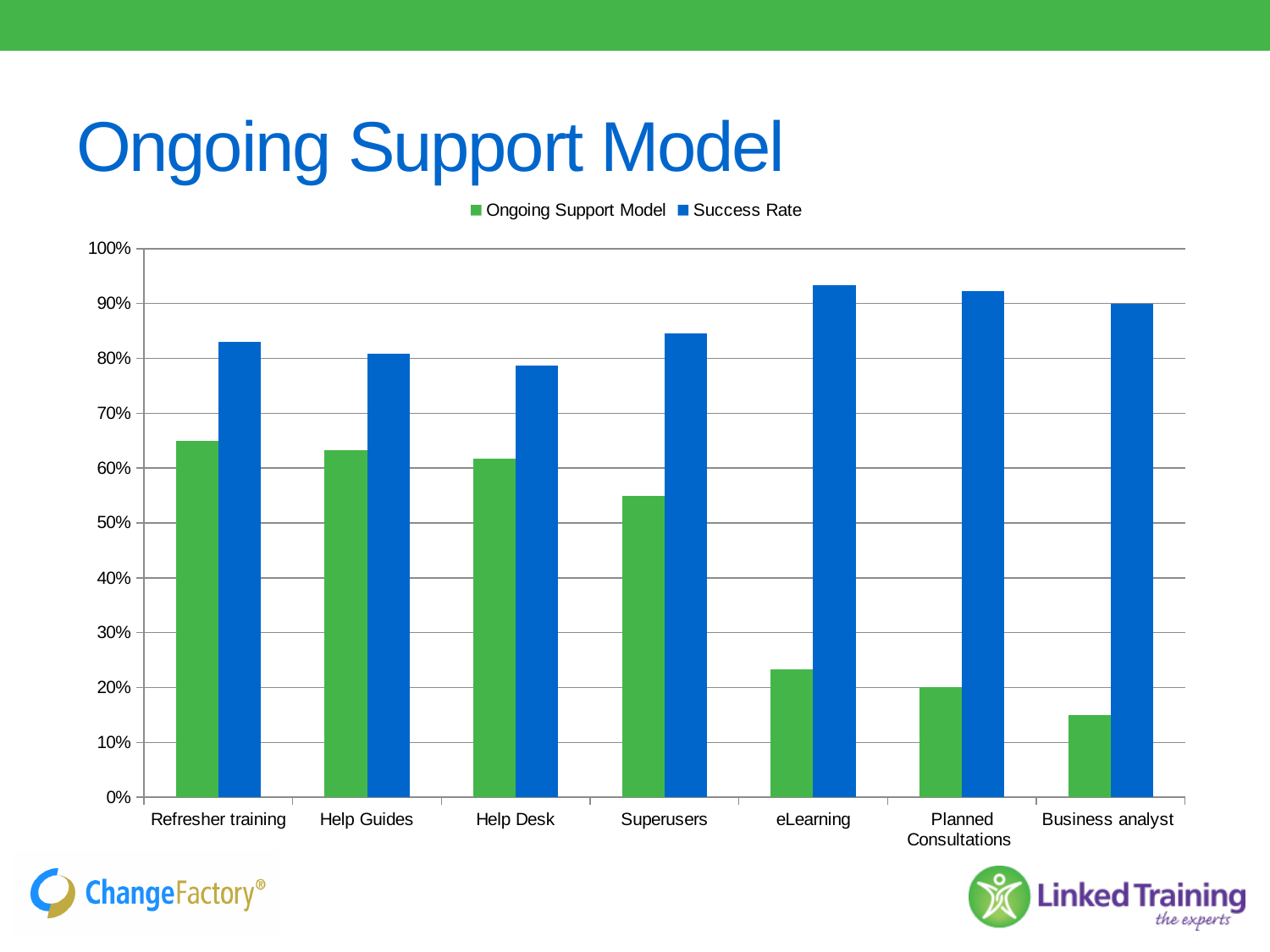
How many categories are shown on the x axis? 7 Which has the larger Ongoing Support Model value, Refresher training or Business analyst? Refresher training Is the Ongoing Support Model value for eLearning greater or less than 30%? less For Superusers, which series has the larger value, Ongoing Support Model or Success Rate? Success Rate Which category has the lowest value for the Ongoing Support Model series? Business analyst What colour are the Success Rate bars? blue How many series does the legend list? 2 What kind of chart is shown on the slide? bar chart Is the Ongoing Support Model value for Superusers greater or less than 50%? greater Do the Ongoing Support Model values rise or fall from left to right along the x axis? fall Is the Success Rate value for Refresher training greater or less than 70%? greater